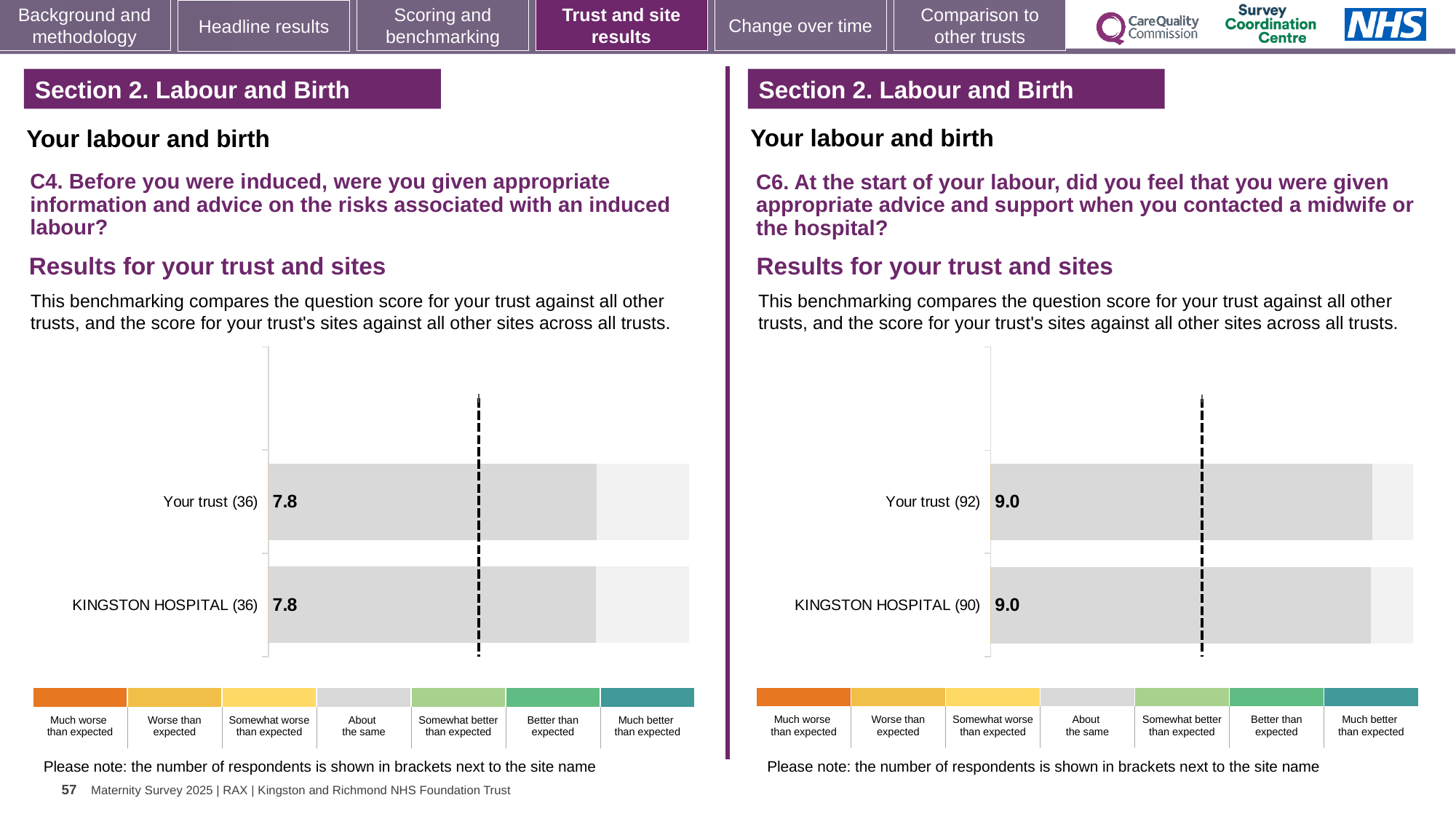
On the right chart (C6), what is the score for KINGSTON HOSPITAL? 9.0 On the right chart (C6), what is the difference between the Your trust score and the KINGSTON HOSPITAL score? 0.0 On the right chart (C6), what is the score for Your trust? 9.0 On the left chart (C4), what is the score for KINGSTON HOSPITAL? 7.8 How many bars are plotted on the right chart (C6)? 2 On the left chart (C4), how many respondents are shown in brackets for Your trust? 36 What kind of chart is used on the left (C4)? Bar chart Is the Your trust score on the right chart (C6) larger or smaller than the Your trust score on the left chart (C4)? Larger How many bars are plotted on the left chart (C4)? 2 On the left chart (C4), what is the difference between the Your trust score and the KINGSTON HOSPITAL score? 0.0 On the left chart (C4), what is the score for Your trust? 7.8 On the right chart (C6), how many respondents are shown in brackets for KINGSTON HOSPITAL? 90